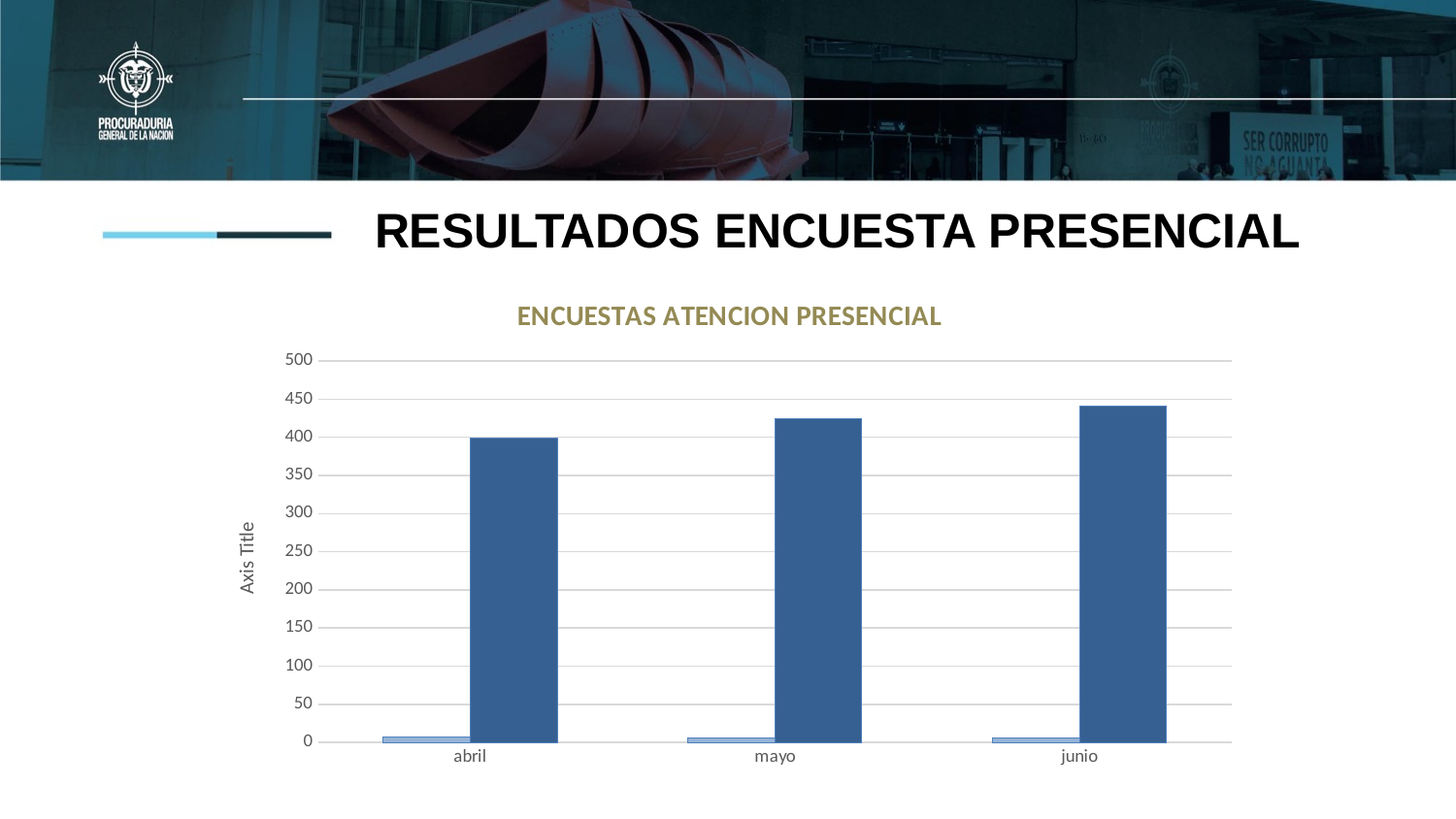
Is the light blue bar for abril greater or less than 50? less Which is larger, the dark blue bar for abril or the dark blue bar for mayo? mayo Is the dark blue bar for mayo greater or less than 400? greater Which month has the tallest dark blue bar? junio What kind of chart is shown on the slide? bar chart What label is shown on the vertical axis of the chart? Axis Title Do the dark blue bars rise or fall from abril to junio? rise Which month has the shortest dark blue bar? abril How many categories are shown on the x axis of the chart? 3 What is the title of the chart? ENCUESTAS ATENCION PRESENCIAL Is the dark blue bar for junio greater or less than 450? less